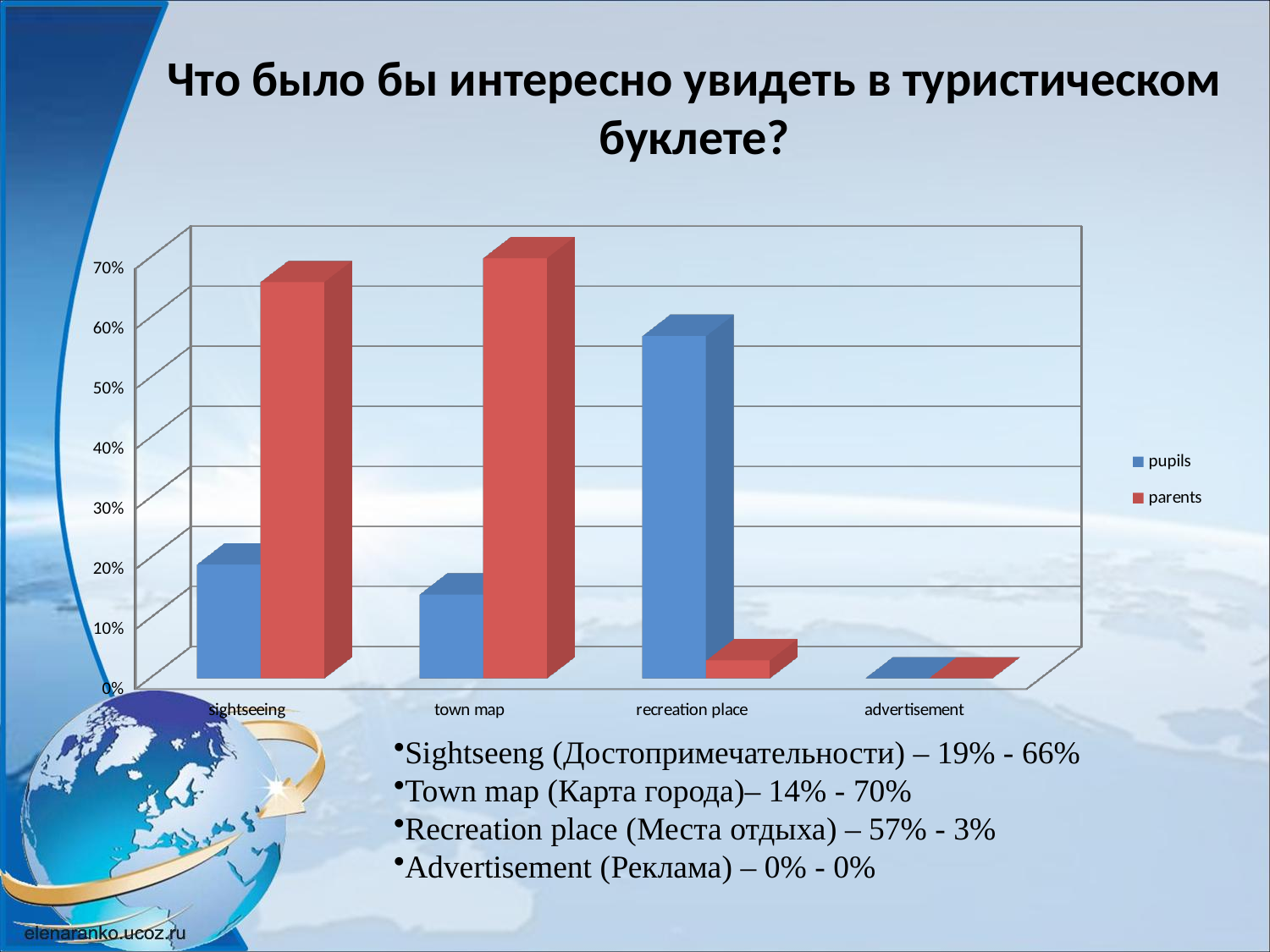
What is the value for pupils for recreation place? 57% What is the value for parents for town map? 70% Which category has the highest value for parents? town map Which category has the highest value for pupils? recreation place Is the value for parents for town map greater or less than 60%? greater How many categories are shown on the x axis of the chart? 4 How many series does the chart legend list? 2 What is the difference between the parents and pupils values for sightseeing? 47% For recreation place, which is larger: the value for pupils or the value for parents? pupils What is the value for parents for sightseeing? 66% What kind of chart is shown on the slide? bar chart Which series is shown in red in the chart? parents